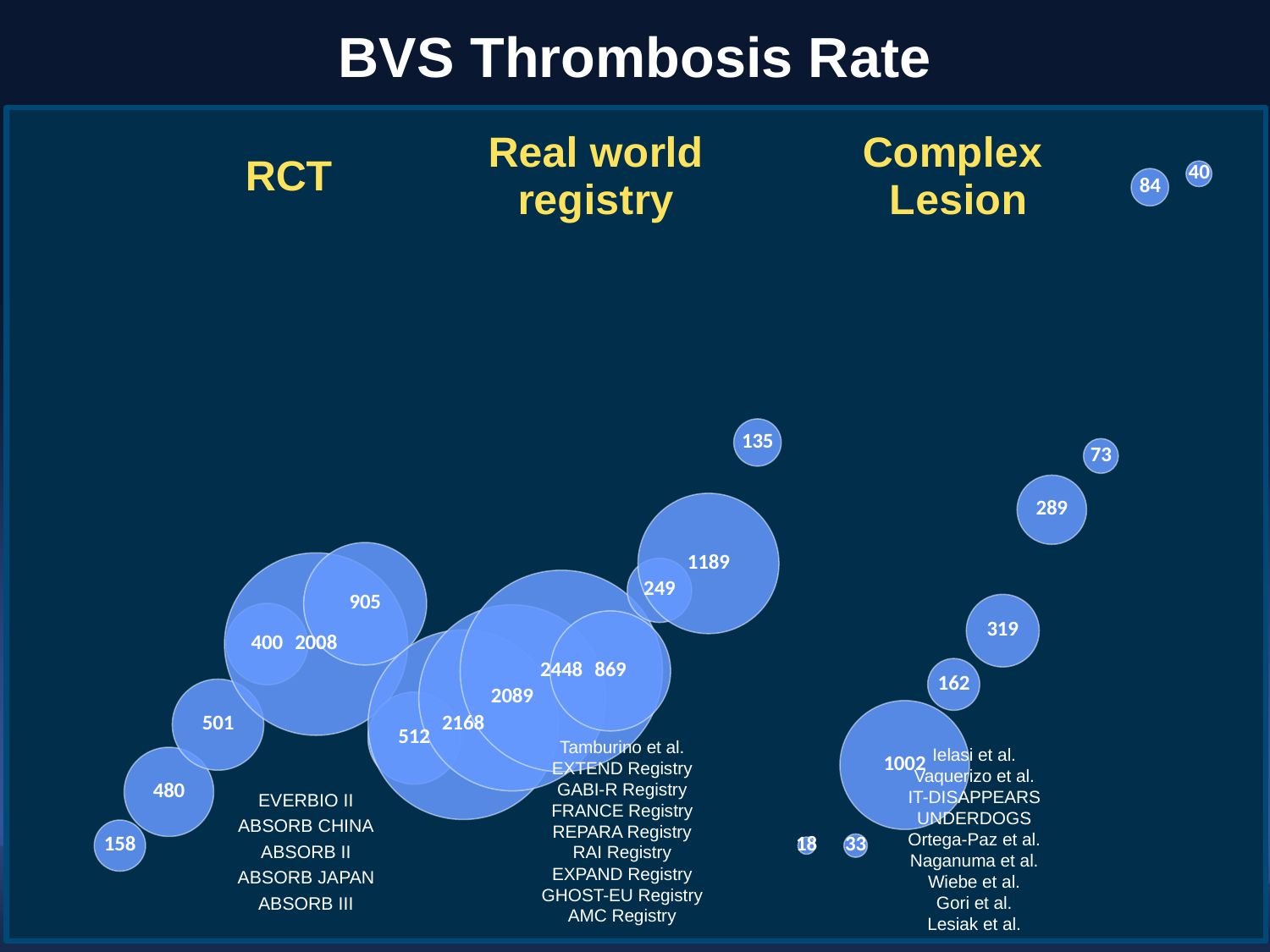
What is the largest number labelled on a bubble in the Complex Lesion group? 1002 What is the title of the chart? BVS Thrombosis Rate Which is larger, the bubble labelled 2448 or the bubble labelled 2168? 2448 What is the largest number labelled on any bubble in the chart? 2448 How many study names are listed under the Real world registry group? 9 What is the difference between the bubble labelled 2448 and the bubble labelled 2168? 280 What is the smallest number labelled on any bubble in the chart? 18 What is the smallest number labelled on a bubble in the RCT group? 158 What are the three group headings shown across the top of the chart? RCT, Real world registry, Complex Lesion What is the largest number labelled on a bubble in the RCT group? 2008 What kind of chart is shown on the slide? bubble chart How many study names are listed under the RCT group? 5